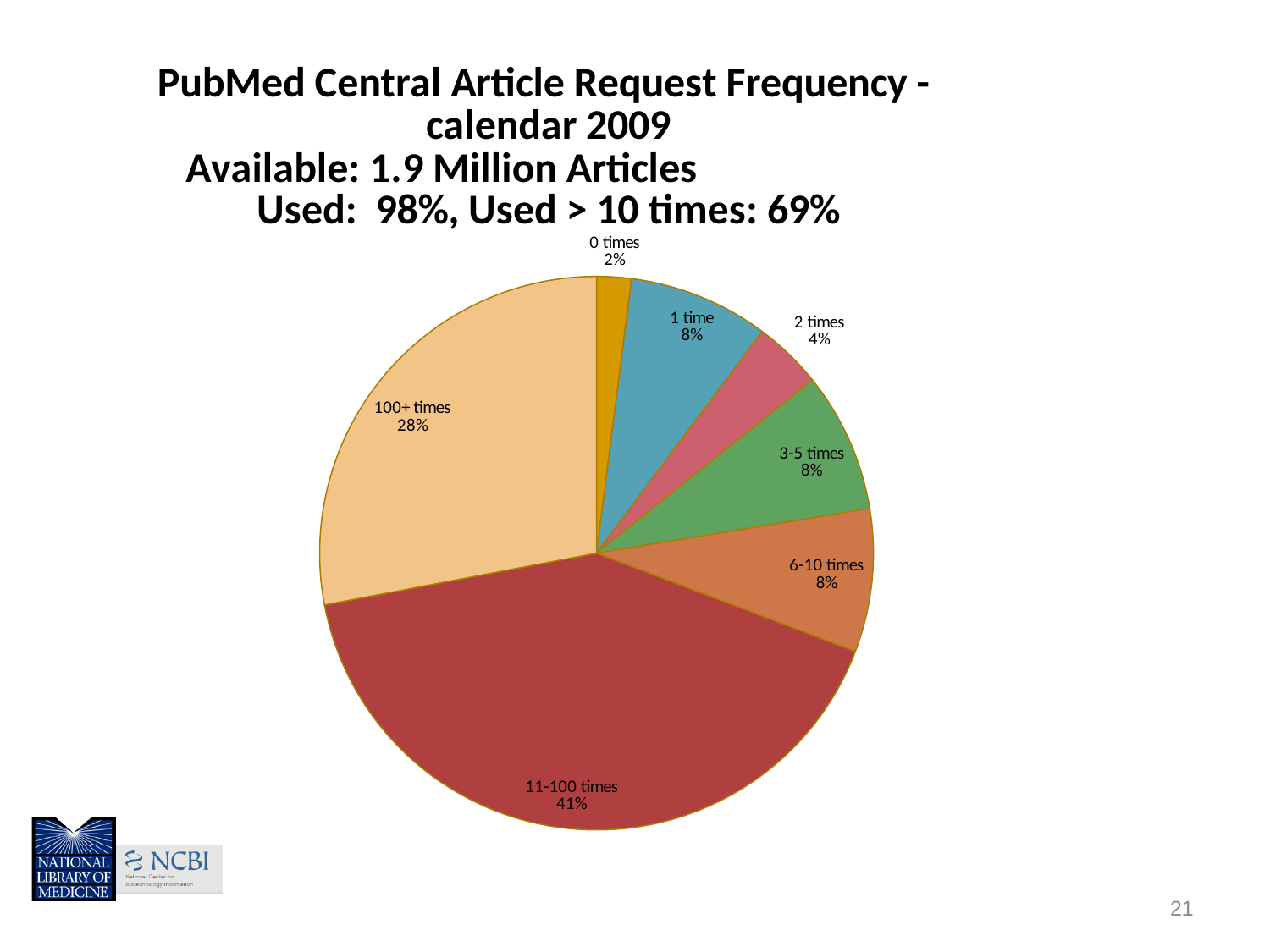
Which category has the largest slice of the pie? 11-100 times What is the combined percentage of the '3-5 times' and '6-10 times' slices? 16% What share of the pie is the '100+ times' slice? 28% How many slices does the pie chart have? 7 Which category has the smallest slice of the pie? 0 times What percentage is shown for '0 times'? 2% What is the title of the chart? PubMed Central Article Request Frequency - calendar 2009 Available: 1.9 Million Articles Used: 98%, Used > 10 times: 69% What kind of chart is shown on the slide? pie chart What percentage is shown for '2 times'? 4% Which is larger, the '1 time' slice or the '2 times' slice? 1 time What share of the pie is the '11-100 times' slice? 41% What is the difference in percentage points between the '11-100 times' slice and the '100+ times' slice? 13